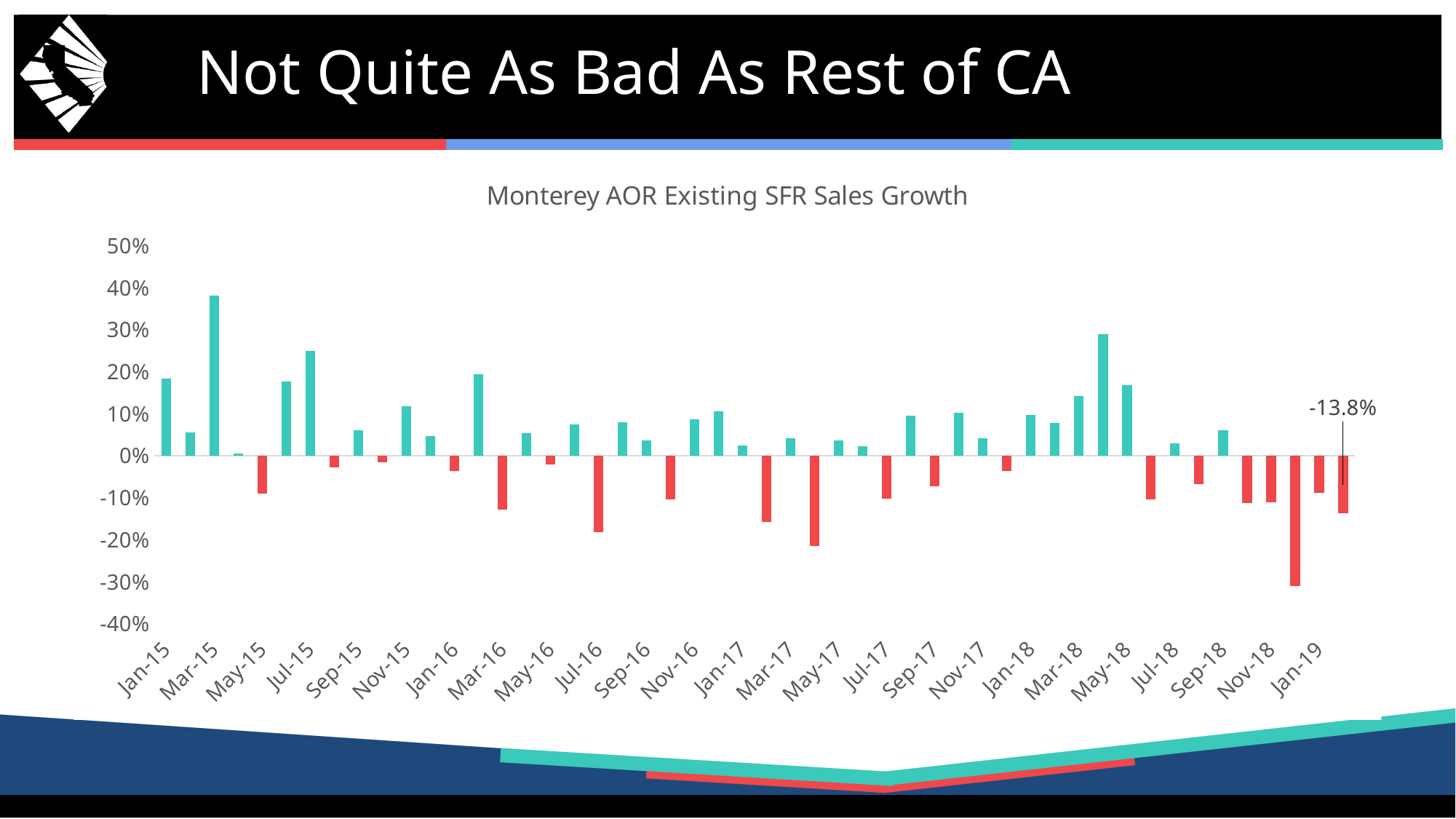
What colour are the bars with negative values? red What type of chart is shown on the slide? bar chart What value is printed as the data label on the last bar of the chart? -13.8% Which month has the highest sales growth value in the chart? Mar-15 What is the title of the chart? Monterey AOR Existing SFR Sales Growth Is the value for Jul-15 greater or less than 20%? greater What is the highest value shown on the y axis? 50% Is the value for Jul-16 greater or less than -10%? less How many month labels are shown on the x axis? 25 Is the value for Mar-15 greater or less than 30%? greater Which has the larger value, Mar-15 or Mar-18? Mar-15